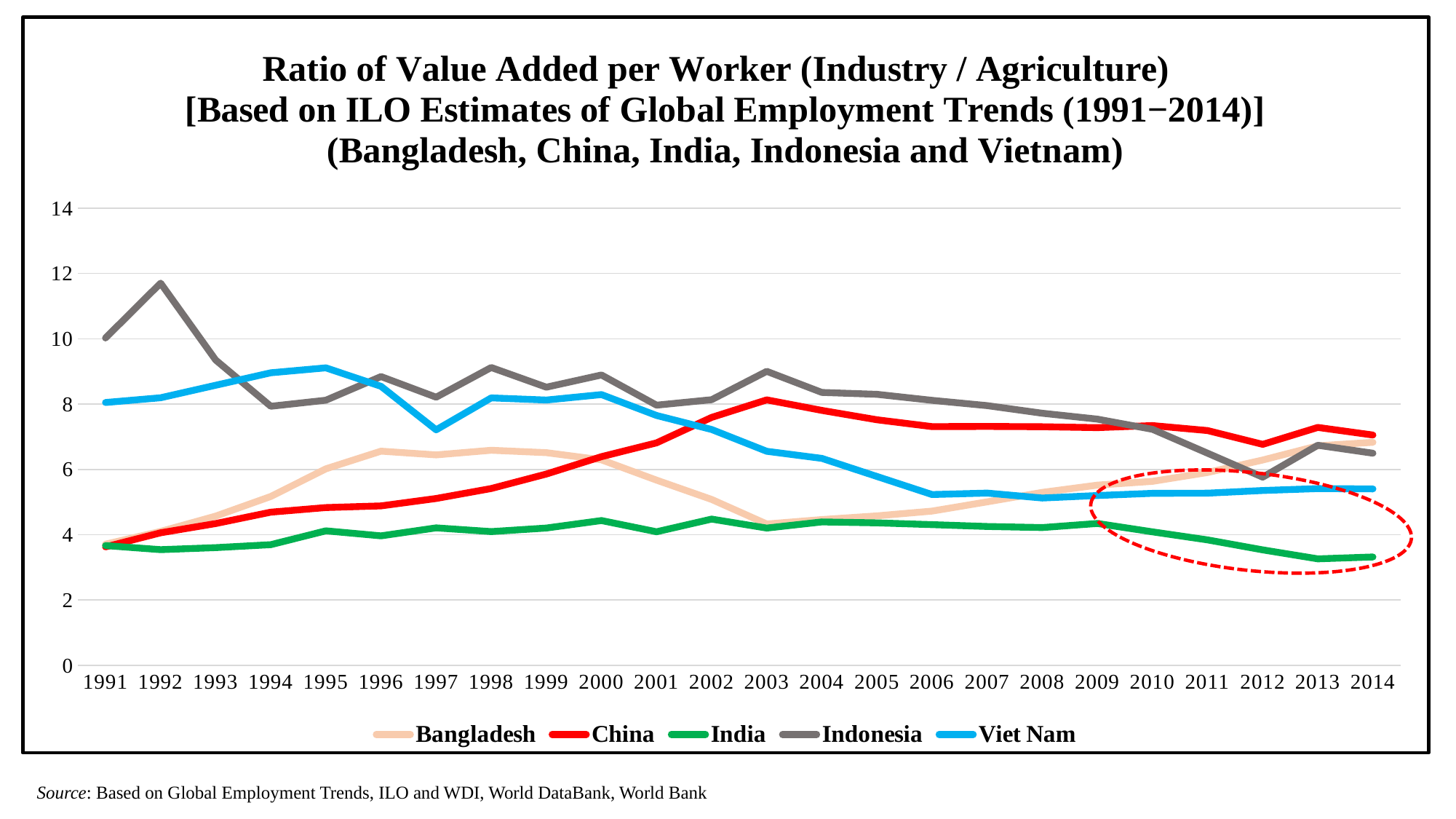
Is the value for Indonesia in 1992 greater or less than 10? greater Does the ratio for India rise or fall from 2009 to 2014? fall Is the value for India in 2014 greater or less than 4? less In 2014, which is larger: the ratio for China or for Viet Nam? China Which country's line is highlighted by the red dashed ellipse? India How many series does the legend list? 5 Which country has the lowest ratio in 2014? India Is the value for Viet Nam in 1995 greater or less than 8? greater What kind of chart is shown on the slide? line chart Which country has the highest ratio in 1992? Indonesia How many years are shown along the x axis? 24 Does the ratio for China rise or fall from 1991 to 2003? rise